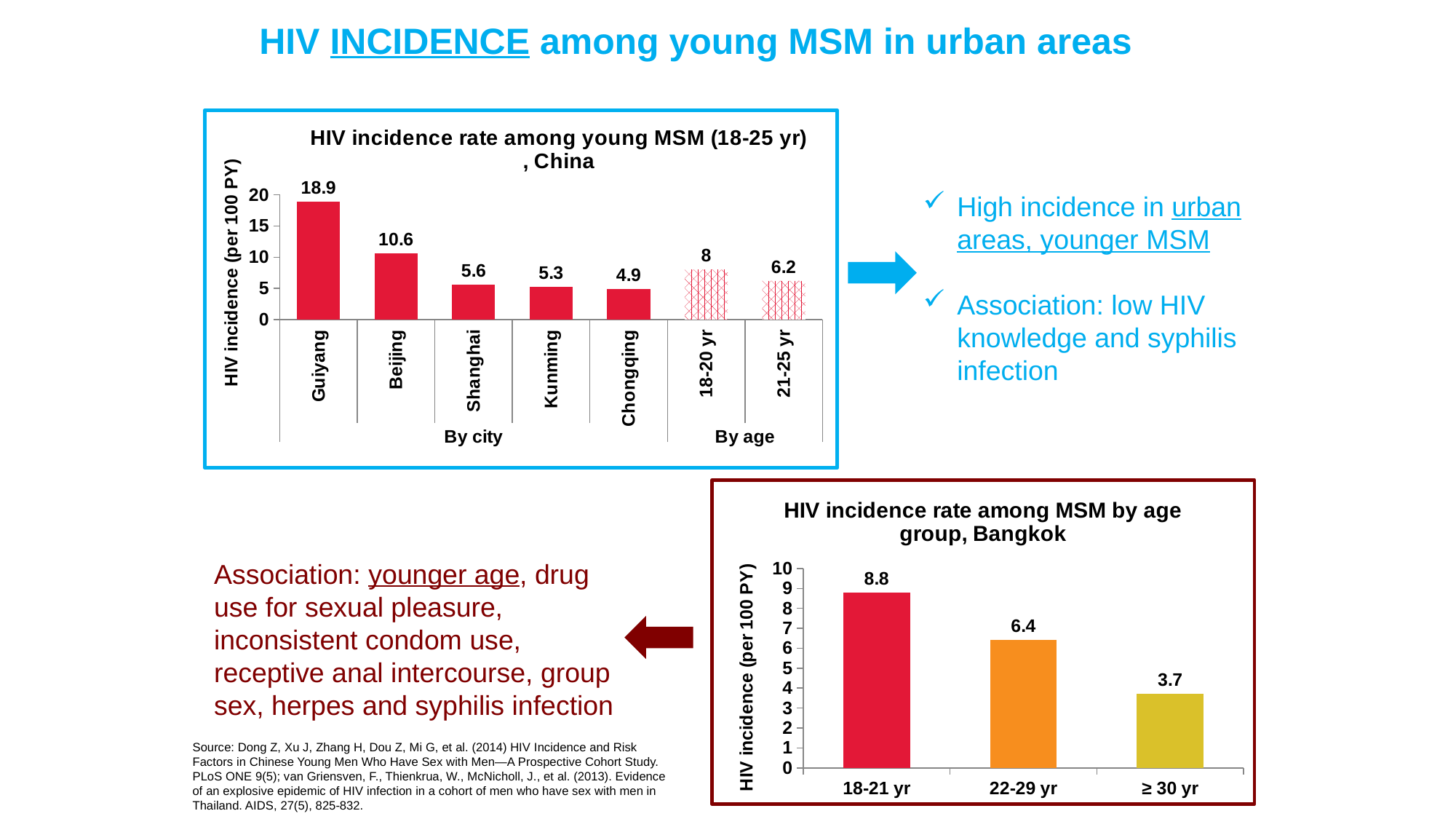
What type of chart is the Bangkok chart? bar chart In the China chart, what is the difference between the HIV incidence rates for Guiyang and Beijing? 8.3 In the Bangkok chart, what is the HIV incidence rate for the 22-29 yr age group? 6.4 In the China chart, which city has the highest HIV incidence rate? Guiyang In the China chart, what is the HIV incidence rate for Guiyang? 18.9 In the China chart, what is the HIV incidence rate for Beijing? 10.6 In the China chart, which city has the lowest HIV incidence rate? Chongqing In the Bangkok chart, what is the difference between the HIV incidence rates for 18-21 yr and ≥ 30 yr? 5.1 In the Bangkok chart, do the values rise or fall as age group increases along the x axis? fall In the China chart, how many bars are plotted in total? 7 In the Bangkok chart, which age group has the lowest HIV incidence rate? ≥ 30 yr In the China chart, which age group has the higher HIV incidence rate, 18-20 yr or 21-25 yr? 18-20 yr